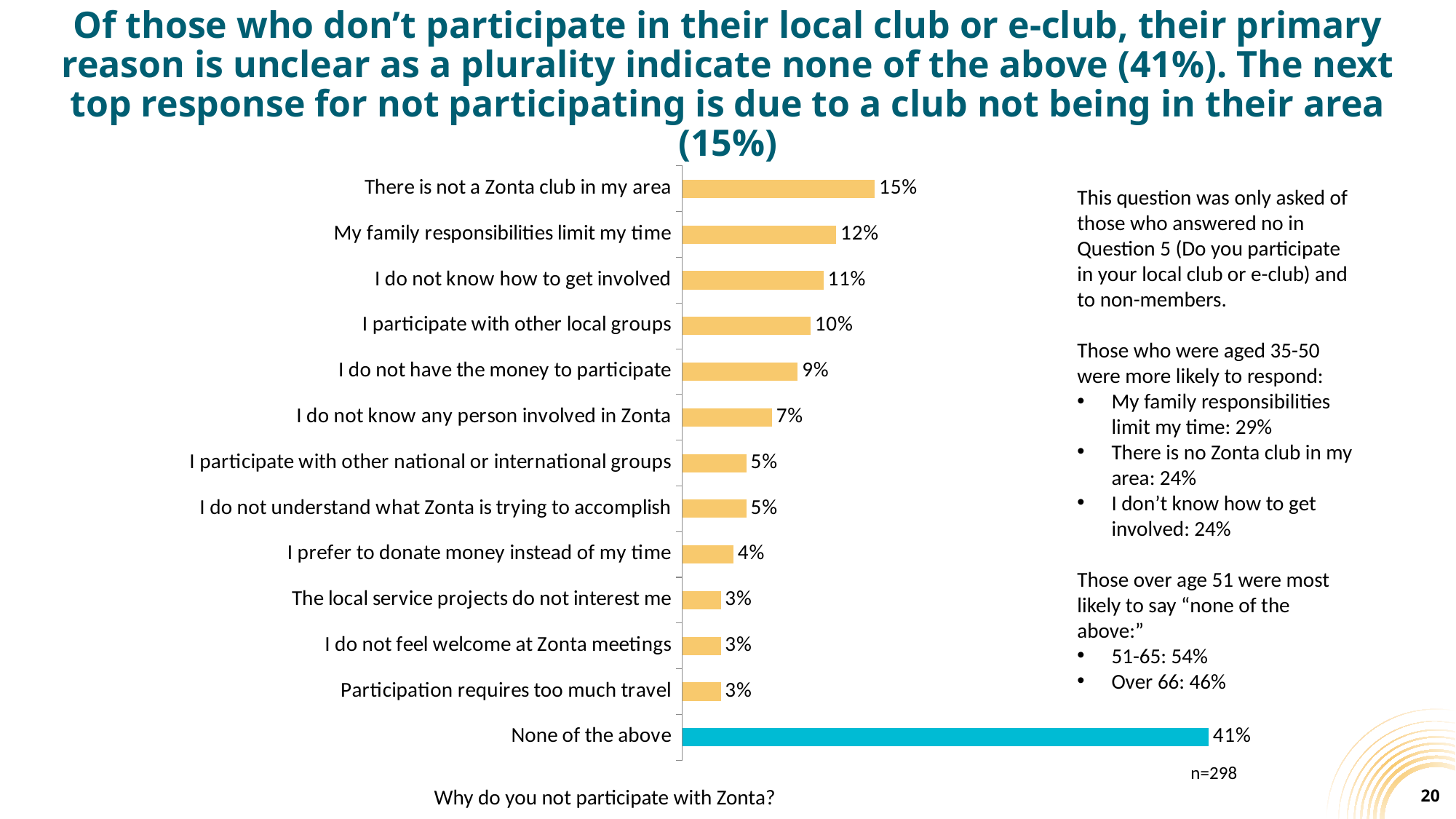
What is the difference in percentage points between 'None of the above' and 'There is not a Zonta club in my area'? 26 How many response categories are shown in the chart? 13 What is the sample size (n) shown for the chart? n=298 What type of chart is shown on the slide? Bar chart What percentage of respondents chose 'None of the above'? 41% What percentage said 'I do not have the money to participate'? 9% What survey question is shown as the chart's caption? Why do you not participate with Zonta? What is the difference in percentage points between 'There is not a Zonta club in my area' and 'My family responsibilities limit my time'? 3 Which response has the highest percentage? None of the above Which is larger: 'I do not know how to get involved' or 'I participate with other local groups'? I do not know how to get involved What percentage of respondents said there is not a Zonta club in their area? 15% What percentage said 'I prefer to donate money instead of my time'? 4%